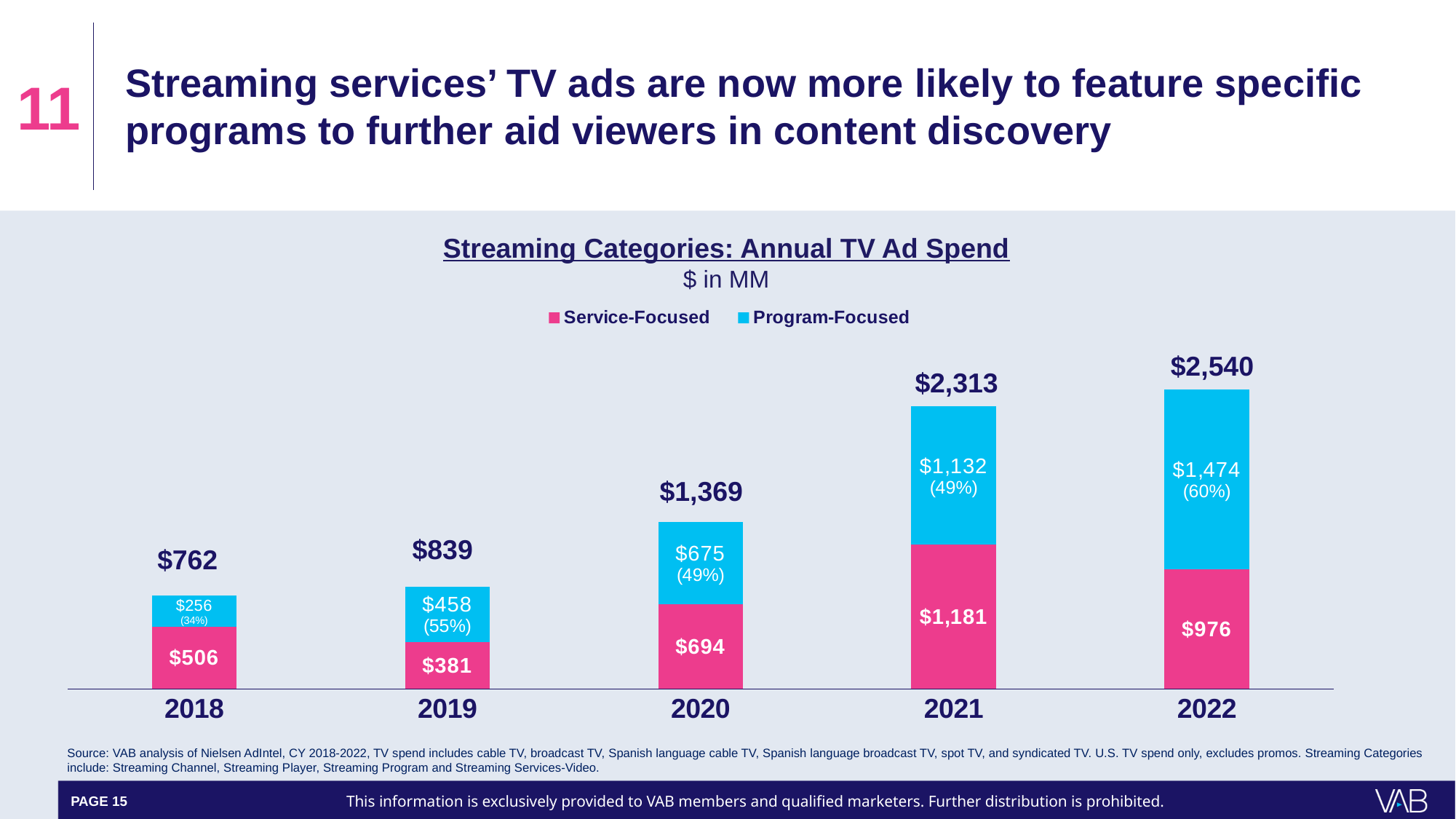
In 2019, which is larger: Service-Focused or Program-Focused spend? Program-Focused Does the total annual TV ad spend rise or fall from 2018 to 2022? Rise What share of the 2022 total is Program-Focused spend? 60% How many years are shown on the x axis? 5 Which year has the lowest Service-Focused TV ad spend? 2019 What is the difference between the Service-Focused spend in 2021 and in 2022? $205 What is the total annual TV ad spend shown for 2021? $2,313 What kind of chart is shown on the slide? Stacked bar chart What is the Program-Focused TV ad spend for 2022? $1,474 How many series does the legend list? 2 What is the Service-Focused TV ad spend for 2020? $694 Which year has the highest total annual TV ad spend? 2022